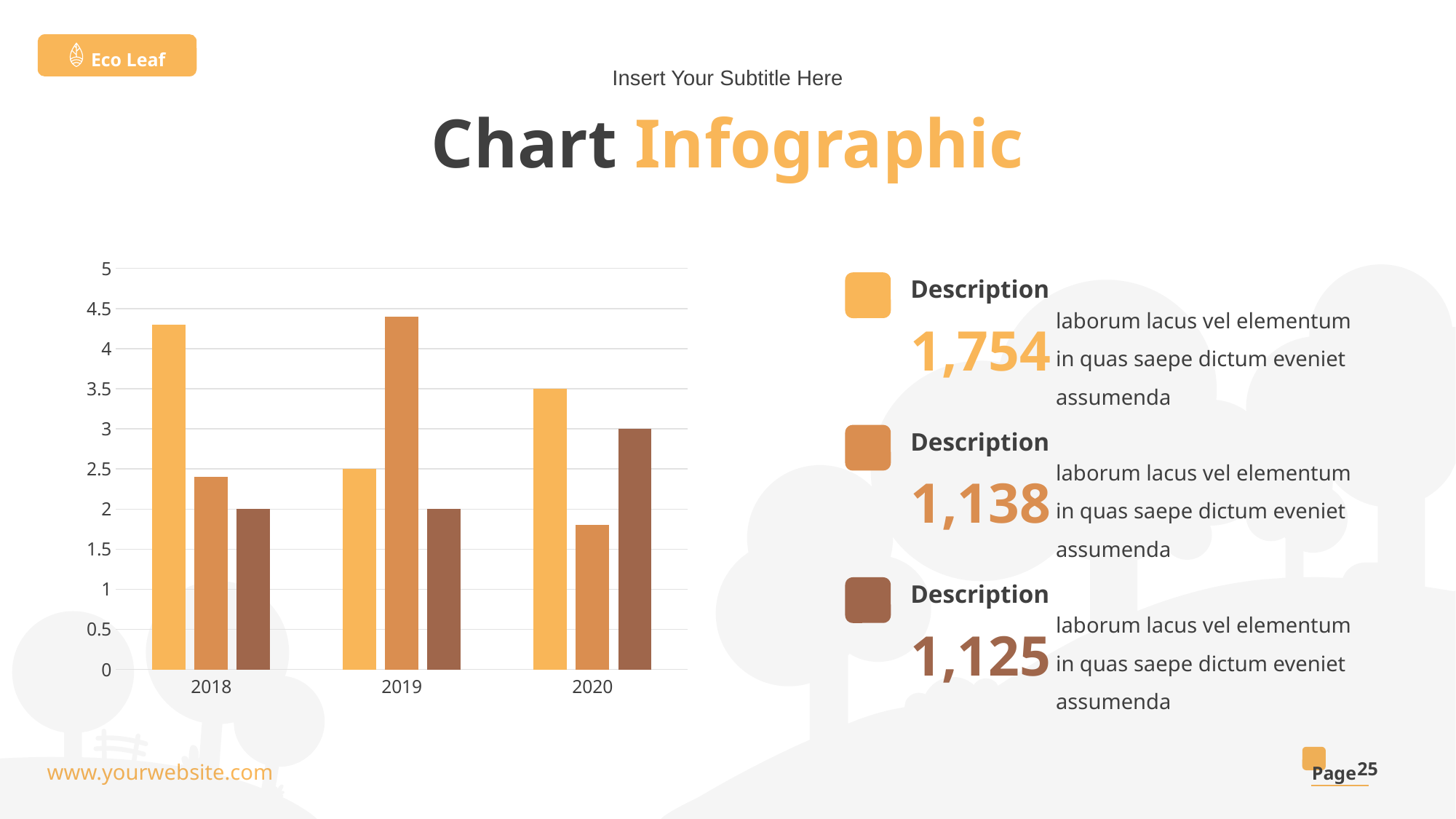
Which year has the shortest light orange bar? 2019 Is the value of the medium orange bar for 2020 greater or less than 2? less Which is larger for 2018, the light orange bar or the brown bar? light orange bar What kind of chart is shown on the slide? bar chart Is the value of the light orange bar for 2018 greater or less than 4? greater Which year has the tallest medium orange bar? 2019 What is the value of the brown bar for 2020? 3 What is the value of the brown bar for 2018? 2 What is the value of the light orange bar for 2020? 3.5 How many categories are shown on the x axis of the chart? 3 What is the difference between the light orange bar and the brown bar for 2020? 0.5 What is the value of the light orange bar for 2019? 2.5